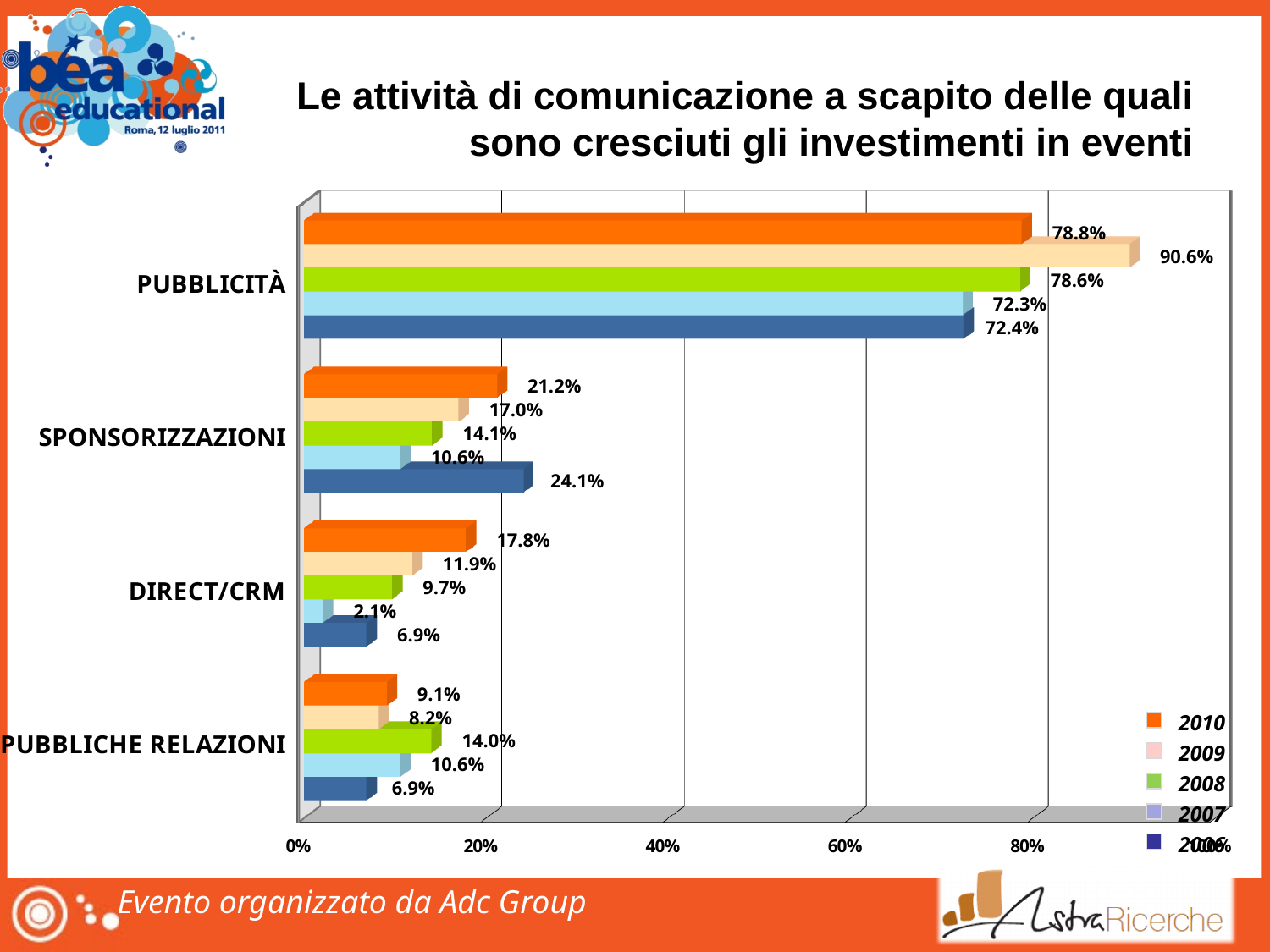
Which colour represents the 2010 series in the legend? orange Which category has the lowest value in 2007? DIRECT/CRM Which category has the highest value in 2010? PUBBLICITÀ What is the difference between the 2009 and 2010 values for PUBBLICITÀ? 11.8% How many categories are shown on the chart? 4 What is the value for PUBBLICHE RELAZIONI in 2008? 14.0% What is the value for DIRECT/CRM in 2007? 2.1% What is the value for PUBBLICITÀ in 2009? 90.6% Which is larger for SPONSORIZZAZIONI: the 2010 value or the 2009 value? 2010 What type of chart is shown on the slide? bar chart How many series does the legend list? 5 What is the value for SPONSORIZZAZIONI in 2006? 24.1%